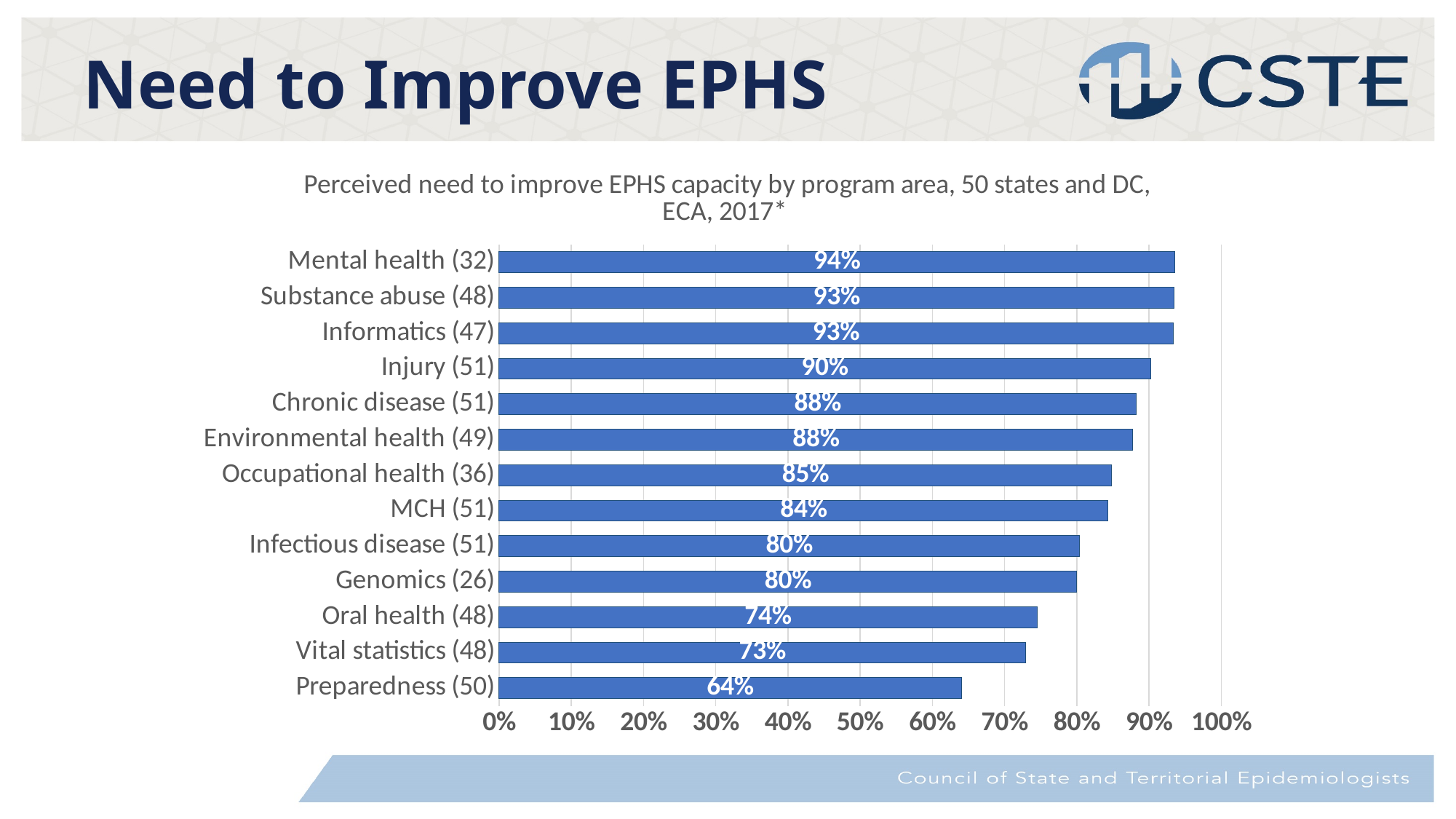
What is the title of the chart? Perceived need to improve EPHS capacity by program area, 50 states and DC, ECA, 2017* Which program area has the lowest perceived need to improve EPHS capacity? Preparedness (50) Is the value for Infectious disease (51) greater or less than 70%? greater What kind of chart is shown on the slide? Bar chart What is the value for Preparedness (50)? 64% Which program area has the highest perceived need to improve EPHS capacity? Mental health (32) Which is larger, the value for Occupational health (36) or the value for Genomics (26)? Occupational health (36) What is the value for Oral health (48)? 74% What is the difference between the values for Injury (51) and Vital statistics (48)? 17% What is the value for Mental health (32)? 94% What is the difference between the values for Mental health (32) and Preparedness (50)? 30% How many program areas are shown in the chart? 13